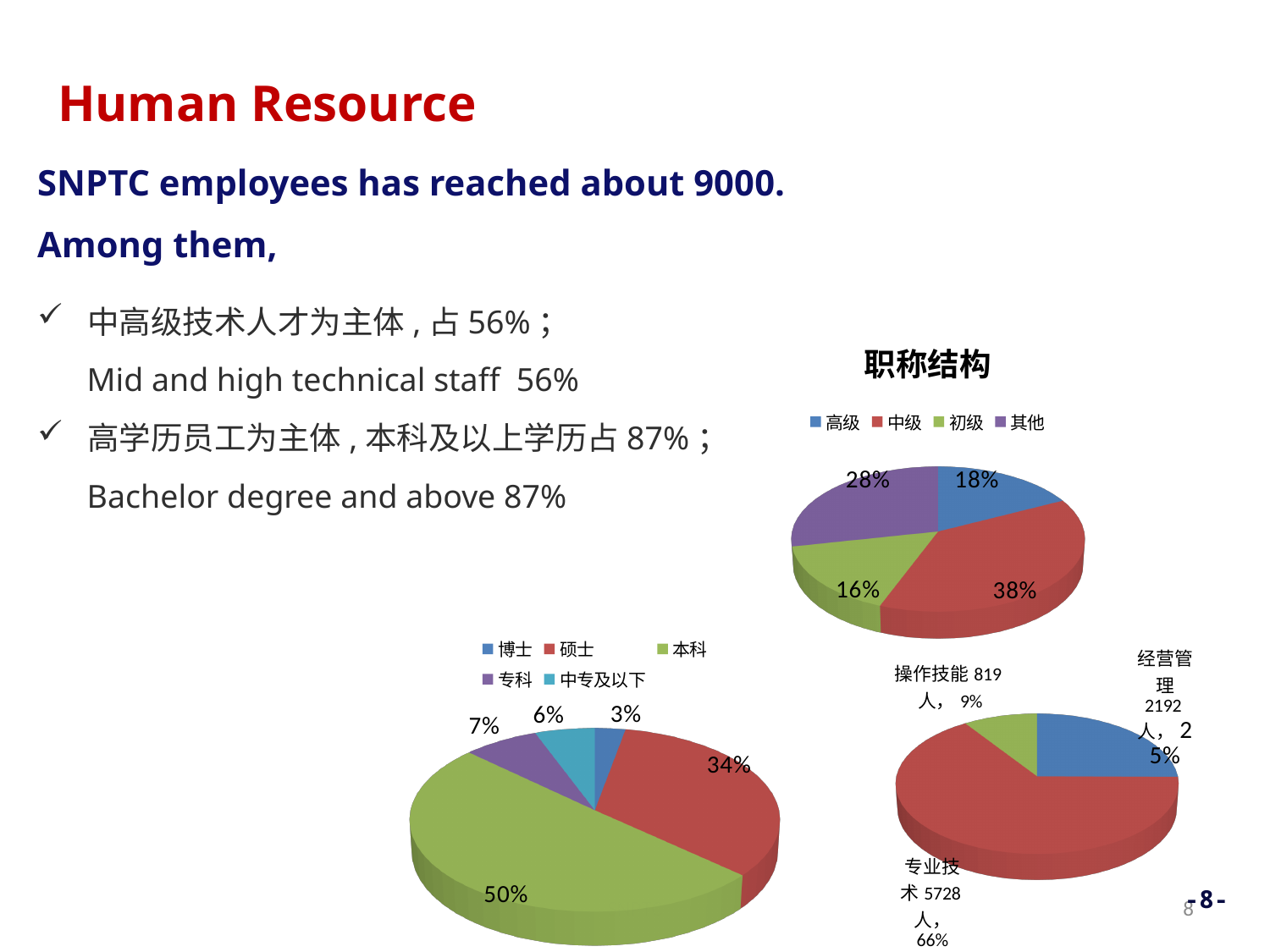
In the pie chart titled 职称结构, which category has the largest share? 中级 In the bottom-right pie chart, what percentage is shown for 操作技能? 9% What type of chart is the chart titled 职称结构? Pie chart In the bottom-left pie chart, how many categories does the legend list? 5 In the pie chart titled 职称结构, what percentage is shown for 中级? 38% In the pie chart titled 职称结构, what is the difference between the shares of 其他 and 高级? 10% In the bottom-left pie chart, what percentage is shown for 本科? 50% In the bottom-left pie chart, which is larger, the share for 专科 or the share for 中专及以下? 专科 In the pie chart titled 职称结构, how many entries does the legend list? 4 In the bottom-right pie chart, how many people are in 专业技术? 5728 In the bottom-left pie chart, which category has the smallest share? 博士 In the pie chart titled 职称结构, which category has the smallest share? 初级